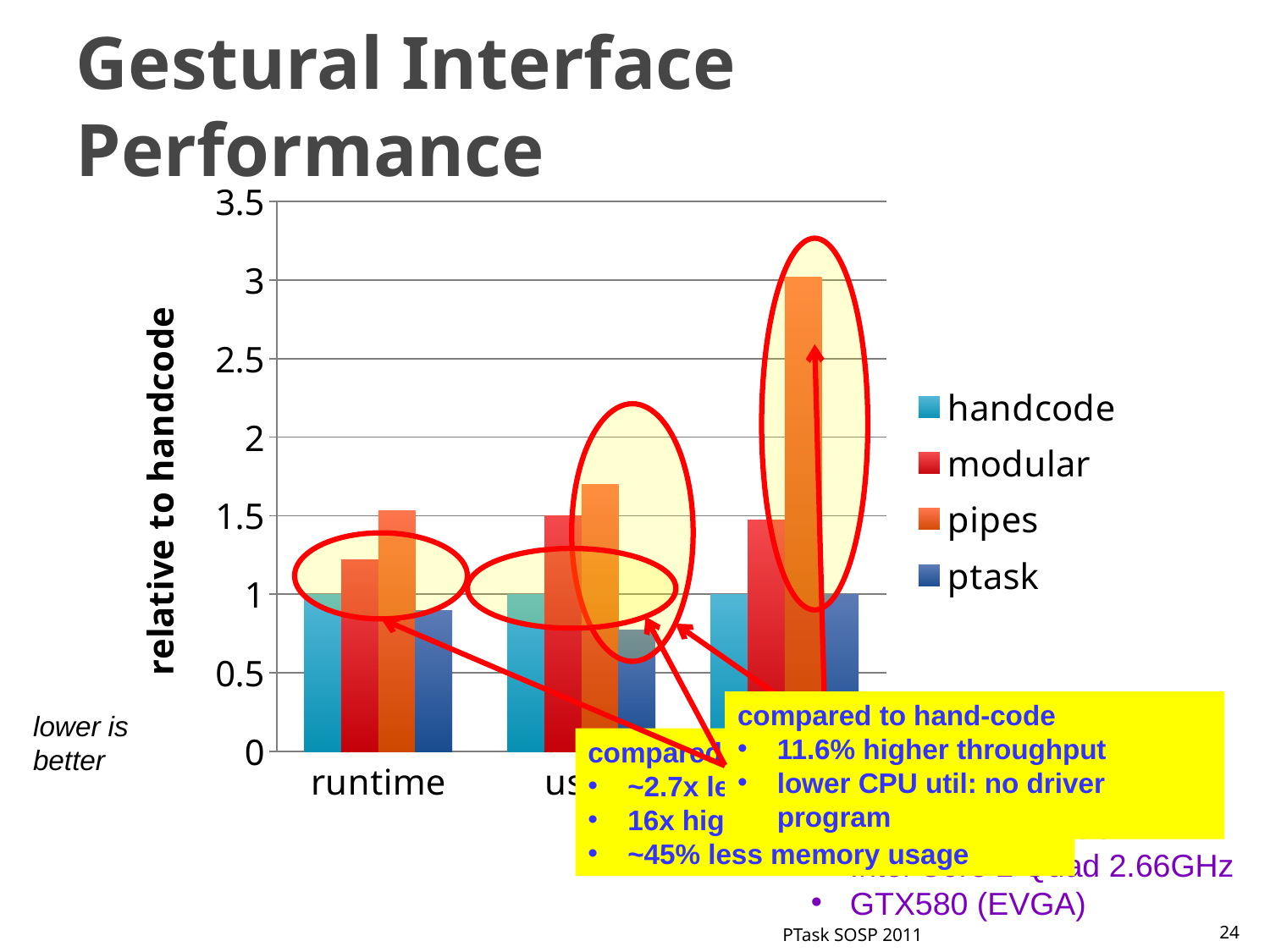
What kind of chart is shown on the slide? bar chart How many category groups of bars are plotted in the chart? 3 What is the title of the vertical axis of the chart? relative to handcode What are the series names listed in the chart legend? handcode, modular, pipes, ptask How many series does the chart legend list? 4 What is the highest tick value shown on the vertical axis? 3.5 Which series has the highest bar in the runtime category? pipes Is the value of modular for the runtime category greater or less than 1? greater Is the value of pipes for the runtime category greater or less than 2? less What is the value of handcode for the runtime category? 1 Which series has the tallest bar anywhere in the chart? pipes For the runtime category, which is larger: modular or pipes? pipes